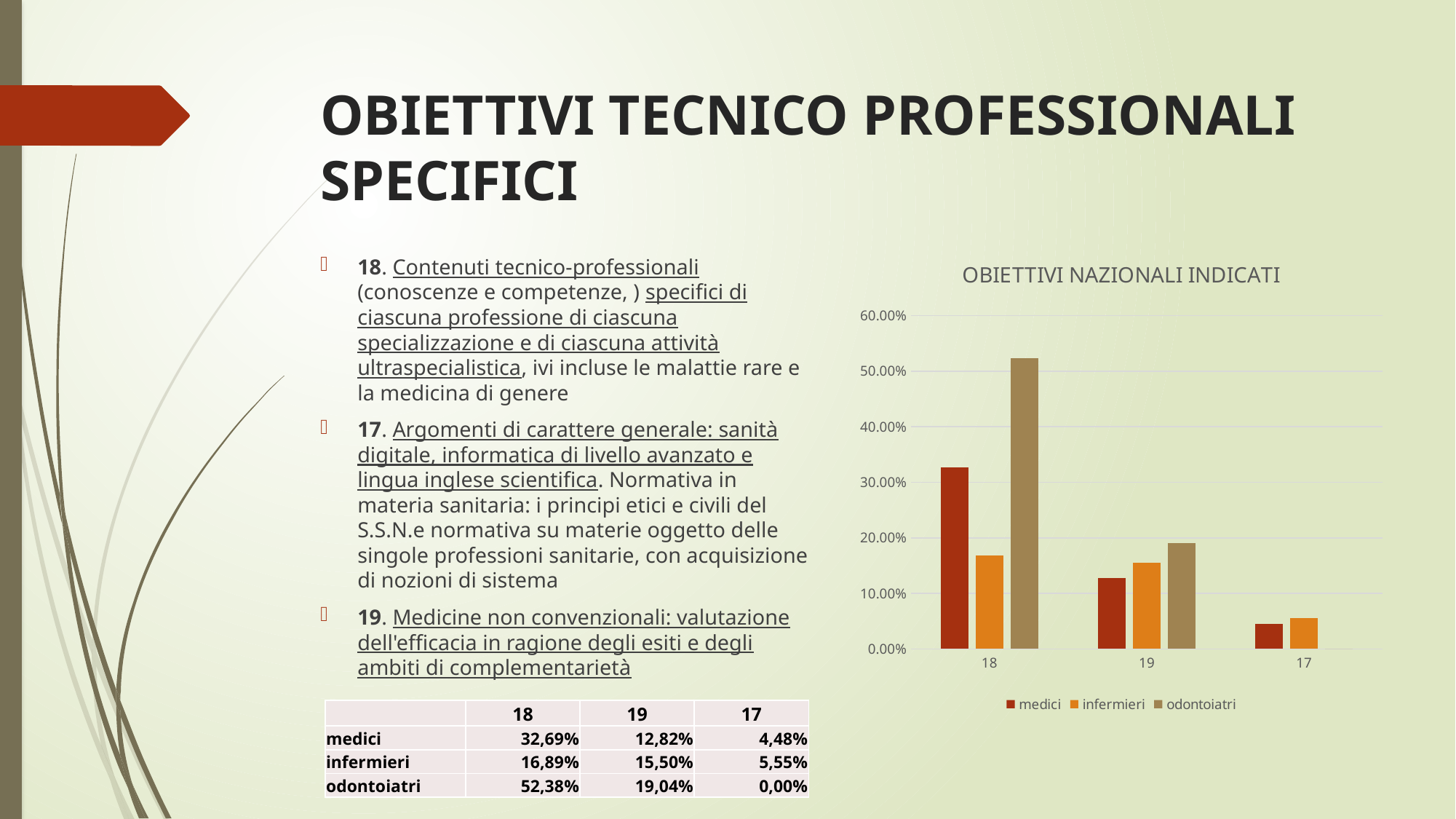
Do the medici values rise or fall moving left to right across the x axis? fall How many series does the legend of the chart list? 3 What kind of chart is shown on the slide? bar chart Which series has the highest value in category 18? odontoiatri In which category does the medici series have its lowest value? 17 What is the difference between the medici value in category 18 and the medici value in category 19? 19,87% Is the value for odontoiatri in category 18 greater or less than 50.00%? greater How many categories are shown on the x axis of the chart? 3 In category 19, which is larger: infermieri or odontoiatri? odontoiatri What is the value for medici in category 19? 12,82% What is the value for odontoiatri in category 18? 52,38% What is the title of the chart? OBIETTIVI NAZIONALI INDICATI